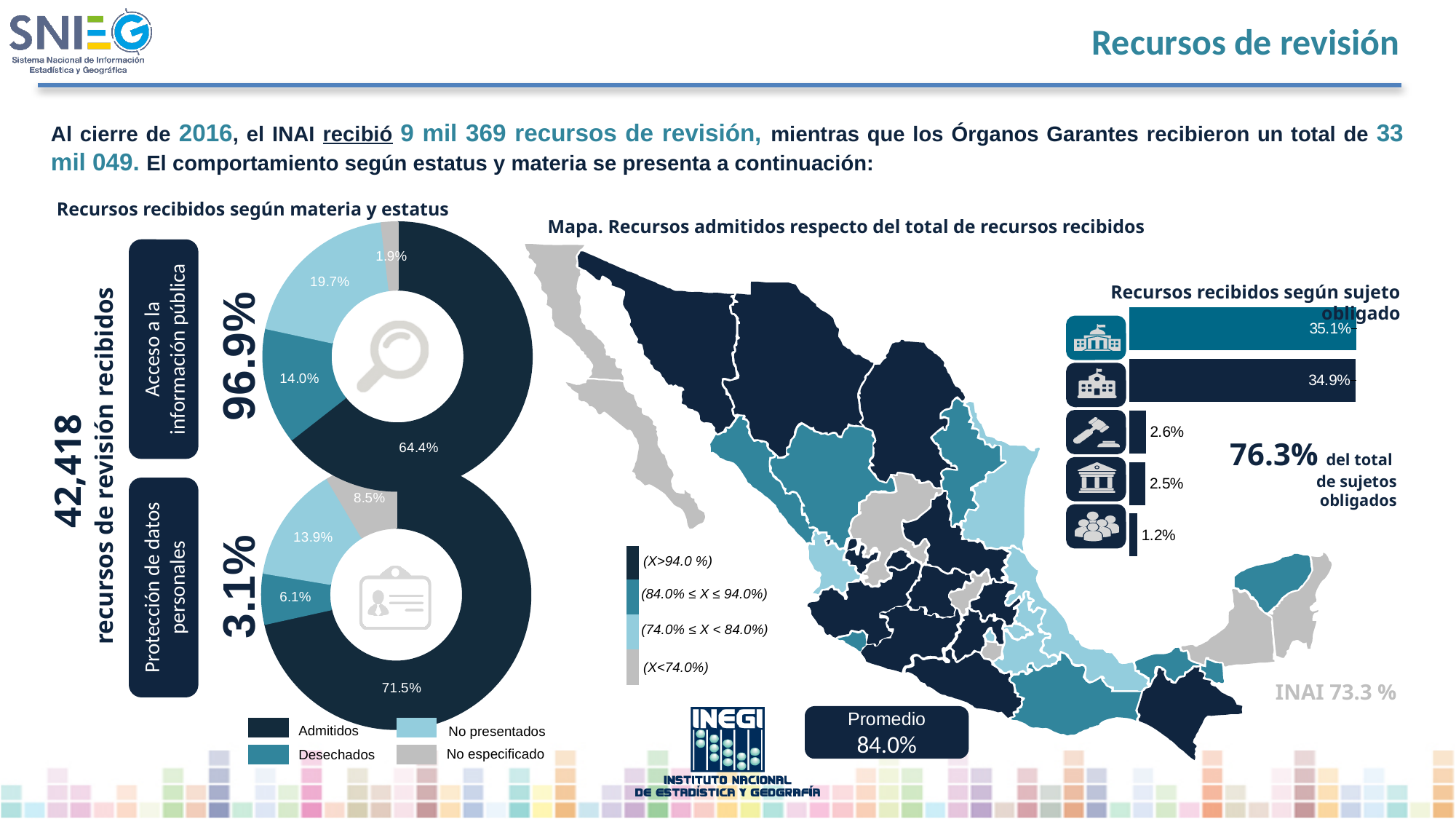
In the 'Protección de datos personales' donut chart, what share is Desechados? 6.1% In the 'Acceso a la información pública' donut chart, what share is Admitidos? 64.4% In the 'Recursos recibidos según sujeto obligado' chart, what is the highest value shown? 35.1% Which is larger: the Desechados share in the 'Acceso a la información pública' donut or the Desechados share in the 'Protección de datos personales' donut? Acceso a la información pública What is the difference between the Admitidos share in the 'Protección de datos personales' donut and the Admitidos share in the 'Acceso a la información pública' donut? 7.1% In the 'Acceso a la información pública' donut chart, what share is No presentados? 19.7% In the 'Protección de datos personales' donut chart, which category has the largest share? Admitidos What type of chart is 'Recursos recibidos según sujeto obligado'? Bar chart In the 'Protección de datos personales' donut chart, what share is No especificado? 8.5% How many categories does the legend of the donut charts list? 4 How many bars are in the 'Recursos recibidos según sujeto obligado' chart? 5 In the 'Acceso a la información pública' donut chart, which category has the smallest share? No especificado